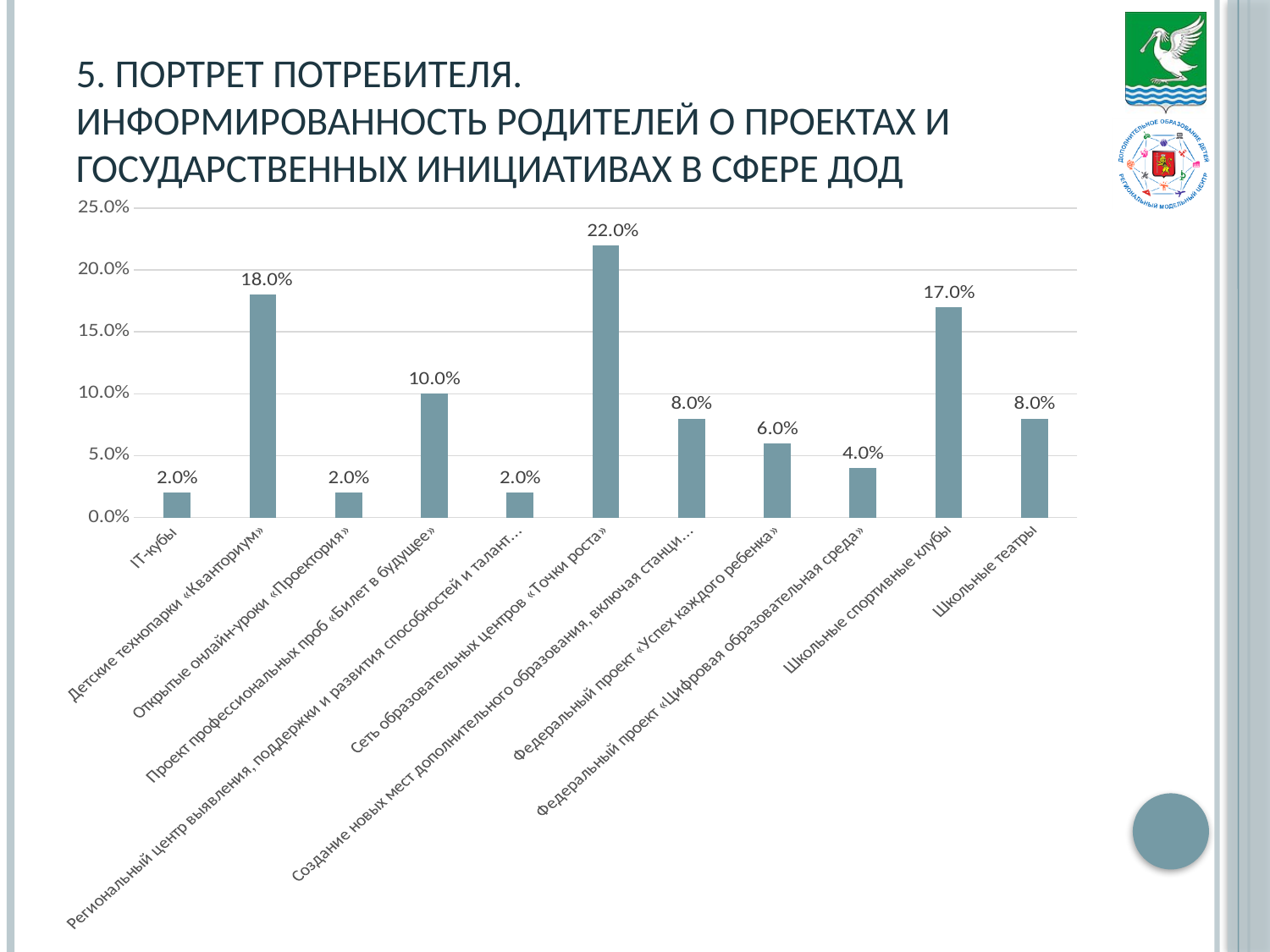
What is the difference between the values for «Школьные спортивные клубы» and «Федеральный проект «Цифровая образовательная среда»»? 13.0% What is the value for «Школьные спортивные клубы»? 17.0% Which category has the highest value? Сеть образовательных центров «Точки роста» What kind of chart is shown on the slide? Bar chart What is the difference between the values for «Сеть образовательных центров «Точки роста»» and «Детские технопарки «Кванториум»»? 4.0% What is the value for «Федеральный проект «Успех каждого ребенка»»? 6.0% What is the value for «Школьные театры»? 8.0% What is the value for «IT-кубы»? 2.0% What is the value for «Детские технопарки «Кванториум»»? 18.0% Which is larger: the value for «Проект профессиональных проб «Билет в будущее»» or the value for «Школьные театры»? Проект профессиональных проб «Билет в будущее» What is the value for «Федеральный проект «Цифровая образовательная среда»»? 4.0% How many categories are shown on the x axis? 11